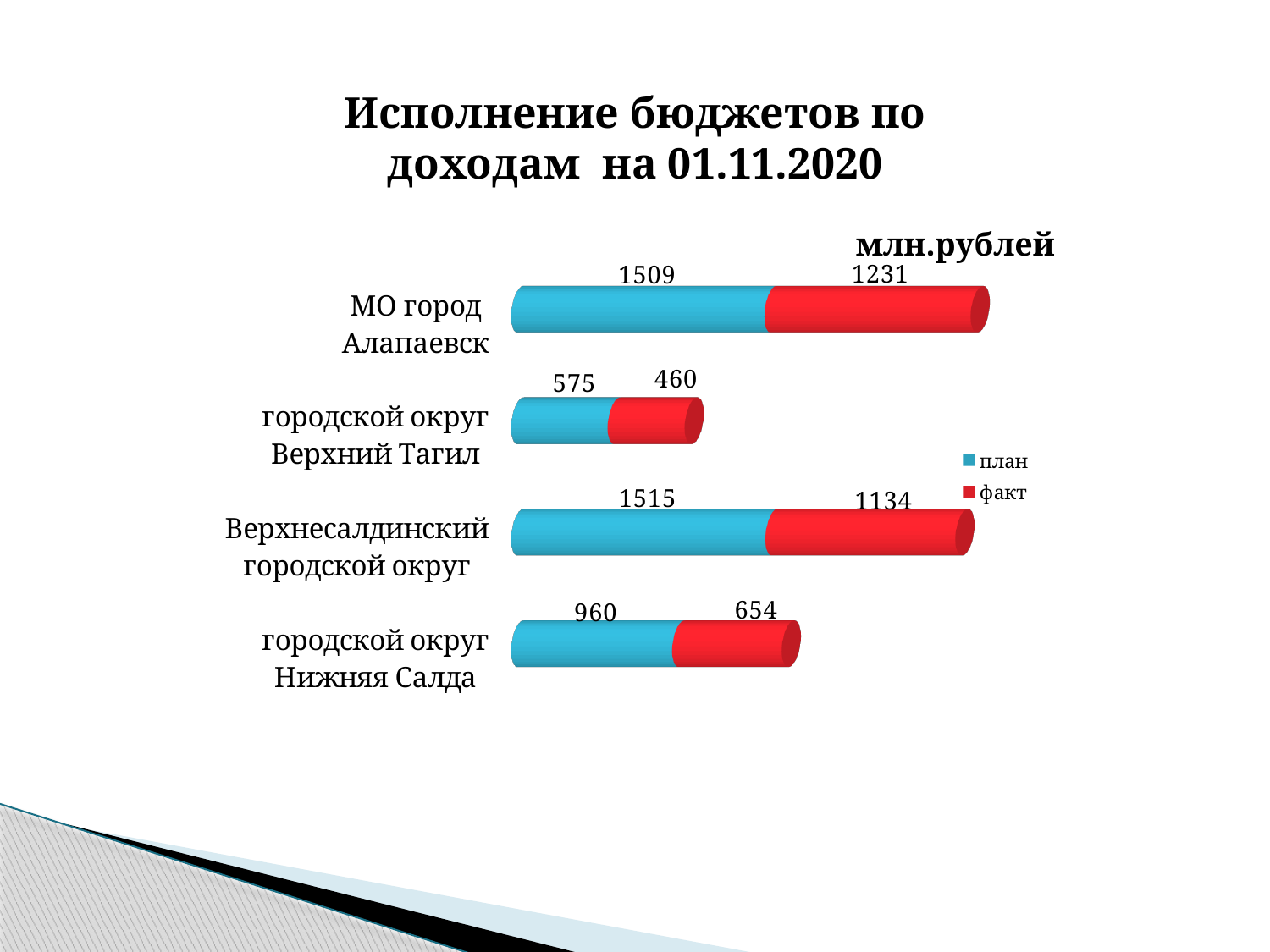
What is the план value for городской округ Нижняя Салда? 960 Which category has the highest факт value? МО город Алапаевск How many series does the legend list? 2 What kind of chart is shown on the slide? bar chart What is the difference between план and факт for МО город Алапаевск? 278 What is the total of the stacked bar for городской округ Верхний Тагил? 1035 What is the план value for МО город Алапаевск? 1509 What is the факт value for Верхнесалдинский городской округ? 1134 Which category has the lowest план value? городской округ Верхний Тагил What is the факт value for городской округ Верхний Тагил? 460 How many categories are shown in the chart? 4 Which is larger: the факт value for городской округ Нижняя Салда or the факт value for городской округ Верхний Тагил? городской округ Нижняя Салда